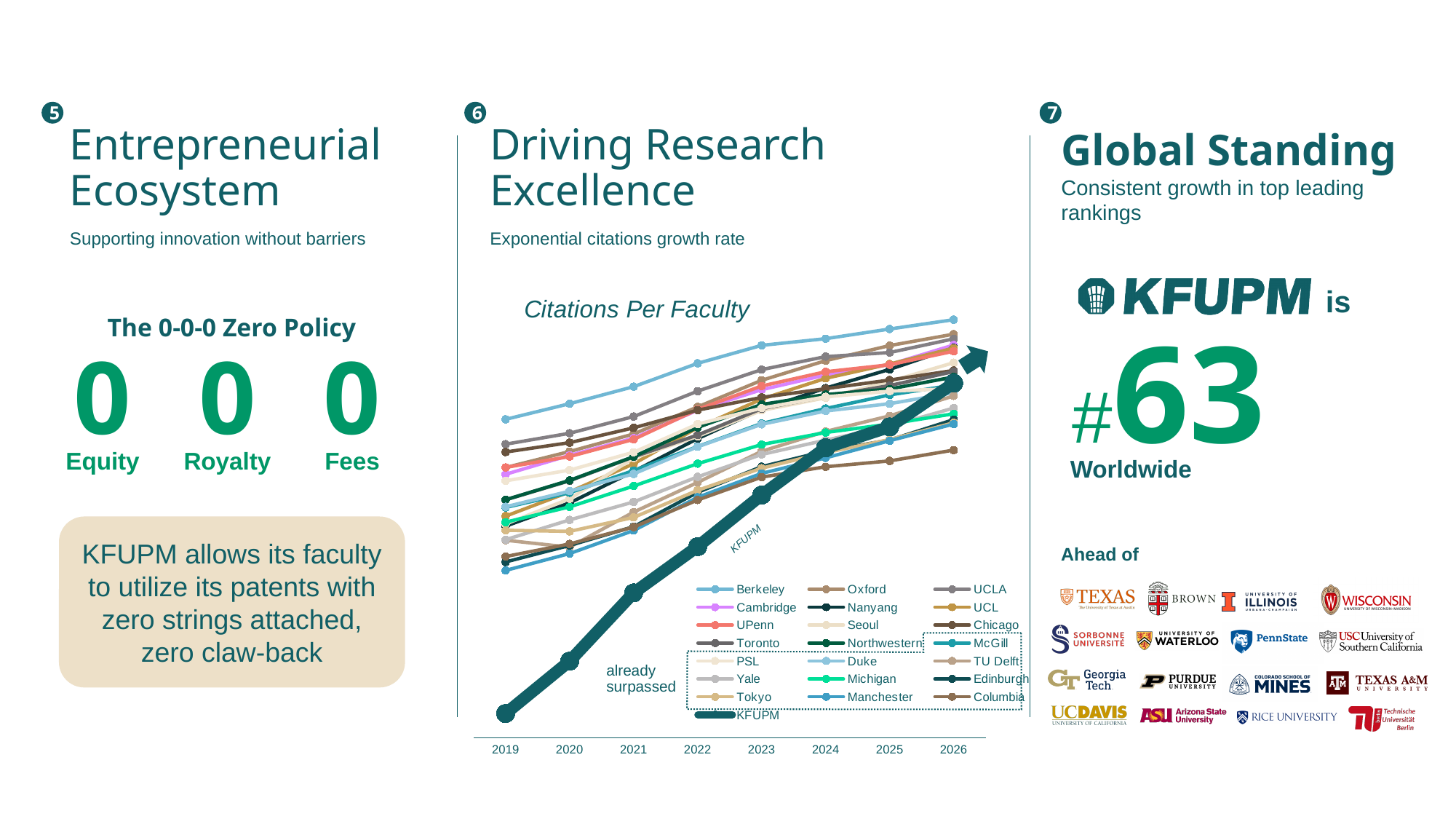
What is the first year shown on the x axis of the Citations Per Faculty chart? 2019 What is the title of the chart on the slide? Citations Per Faculty Which series is drawn with the thick line ending in an arrow in the Citations Per Faculty chart? KFUPM In the Citations Per Faculty chart, does the KFUPM line rise or fall from 2019 to 2026? rise What kind of chart is shown under "Driving Research Excellence"? line chart In the Citations Per Faculty chart, which is larger in 2019: Berkeley or KFUPM? Berkeley Which series has the lowest value in 2019 in the Citations Per Faculty chart? KFUPM How many series does the legend of the Citations Per Faculty chart list? 22 In the Citations Per Faculty chart, does the Berkeley line rise or fall from 2019 to 2026? rise Which series has the highest value in 2026 in the Citations Per Faculty chart? Berkeley In the Citations Per Faculty chart, is the KFUPM value larger in 2019 or in 2026? 2026 How many years are shown along the x axis of the Citations Per Faculty chart? 8